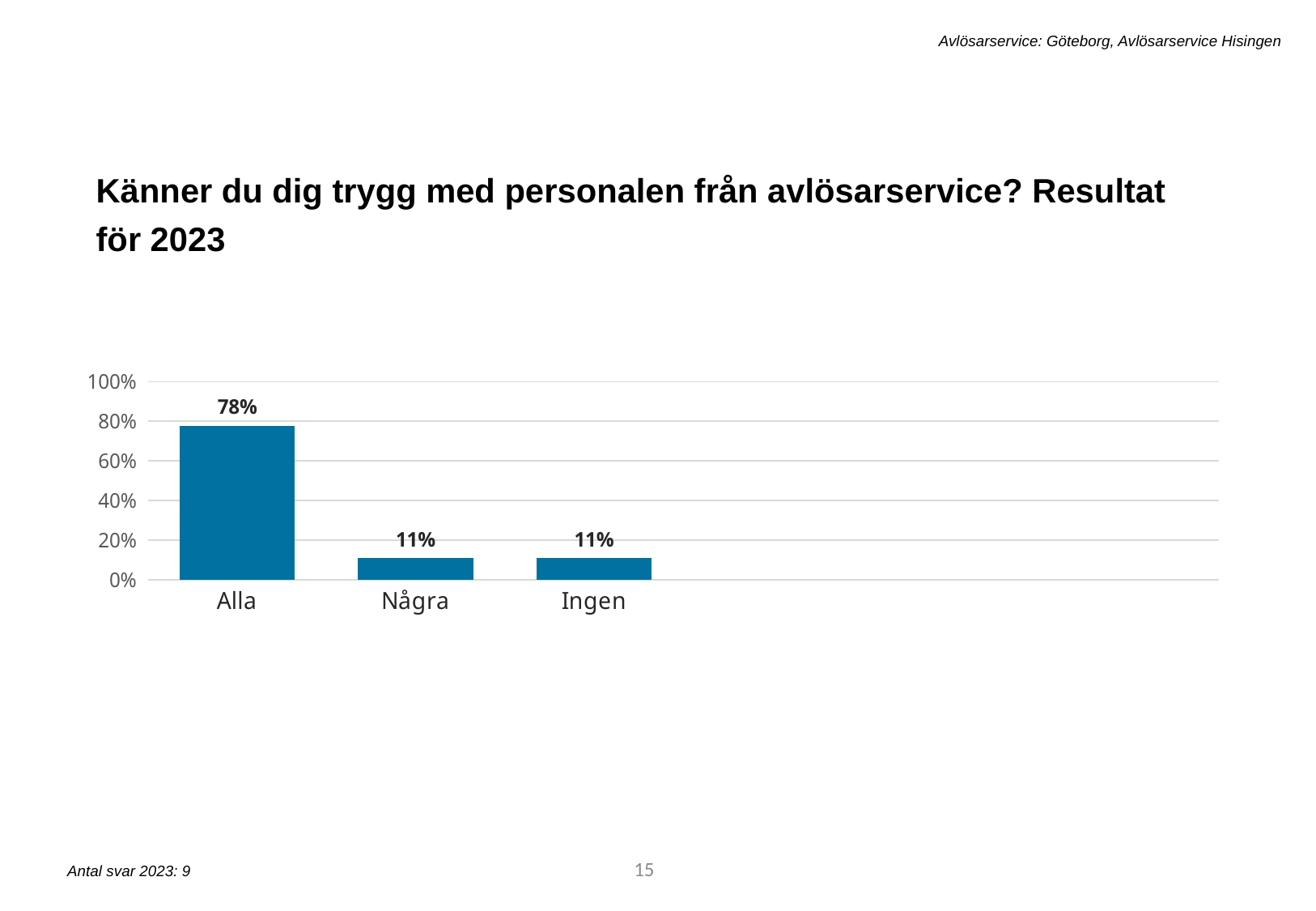
Is the value for Alla greater or less than 60%? greater Is the value for Några greater or less than 20%? less Which is larger, the value for Alla or the value for Ingen? Alla What is the value for Ingen? 11% What kind of chart is shown on the slide? bar chart How many categories are shown on the x axis? 3 What is the title of the slide? Känner du dig trygg med personalen från avlösarservice? Resultat för 2023 What is the highest value shown on the y axis? 100% Which category has the highest value? Alla What is the value for Alla? 78% What is the difference between the values for Alla and Några? 67% What is the value for Några? 11%